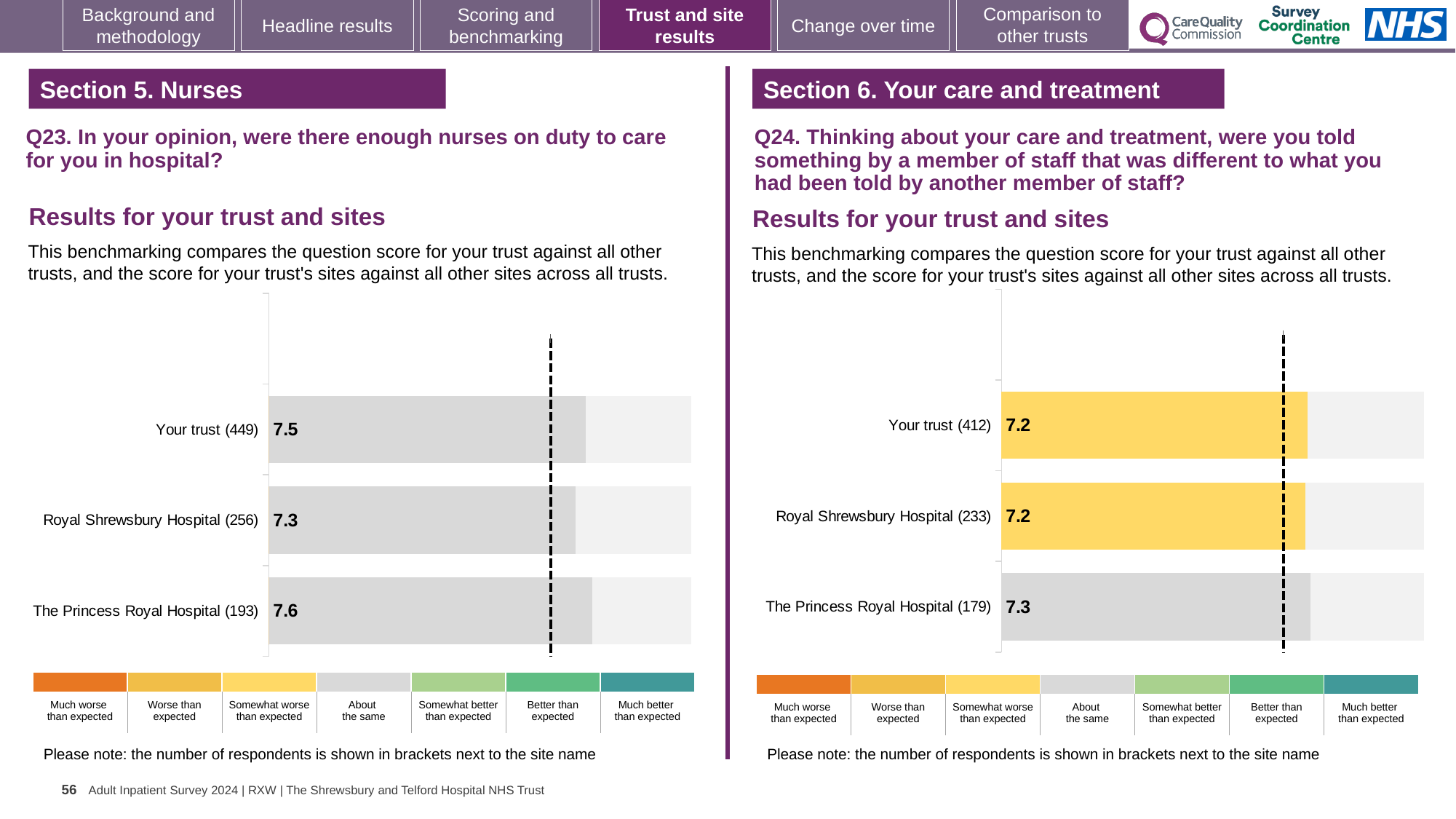
How many bars are plotted in the Q23 chart on the left? 3 In the Q23 chart on the left, what is the score for The Princess Royal Hospital? 7.6 In the Q23 chart on the left, which site or trust has the lowest score? Royal Shrewsbury Hospital In the Q23 chart on the left, what is the score for Your trust? 7.5 In the Q23 chart on the left, what is the difference between the scores for The Princess Royal Hospital and Royal Shrewsbury Hospital? 0.3 In the Q23 chart on the left, which site or trust has the highest score? The Princess Royal Hospital What type of chart is used in the Q24 chart on the right? bar chart In the Q24 chart on the right, is the score for The Princess Royal Hospital larger or smaller than the score for Your trust? larger In the Q24 chart on the right, what is the score for Royal Shrewsbury Hospital? 7.2 In the Q24 chart on the right, which site or trust has the highest score? The Princess Royal Hospital In the Q24 chart on the right, which benchmark category does the yellow colour of the Your trust bar correspond to in the legend? Somewhat worse than expected In the Q24 chart on the right, how many respondents are shown in brackets for Your trust? 412